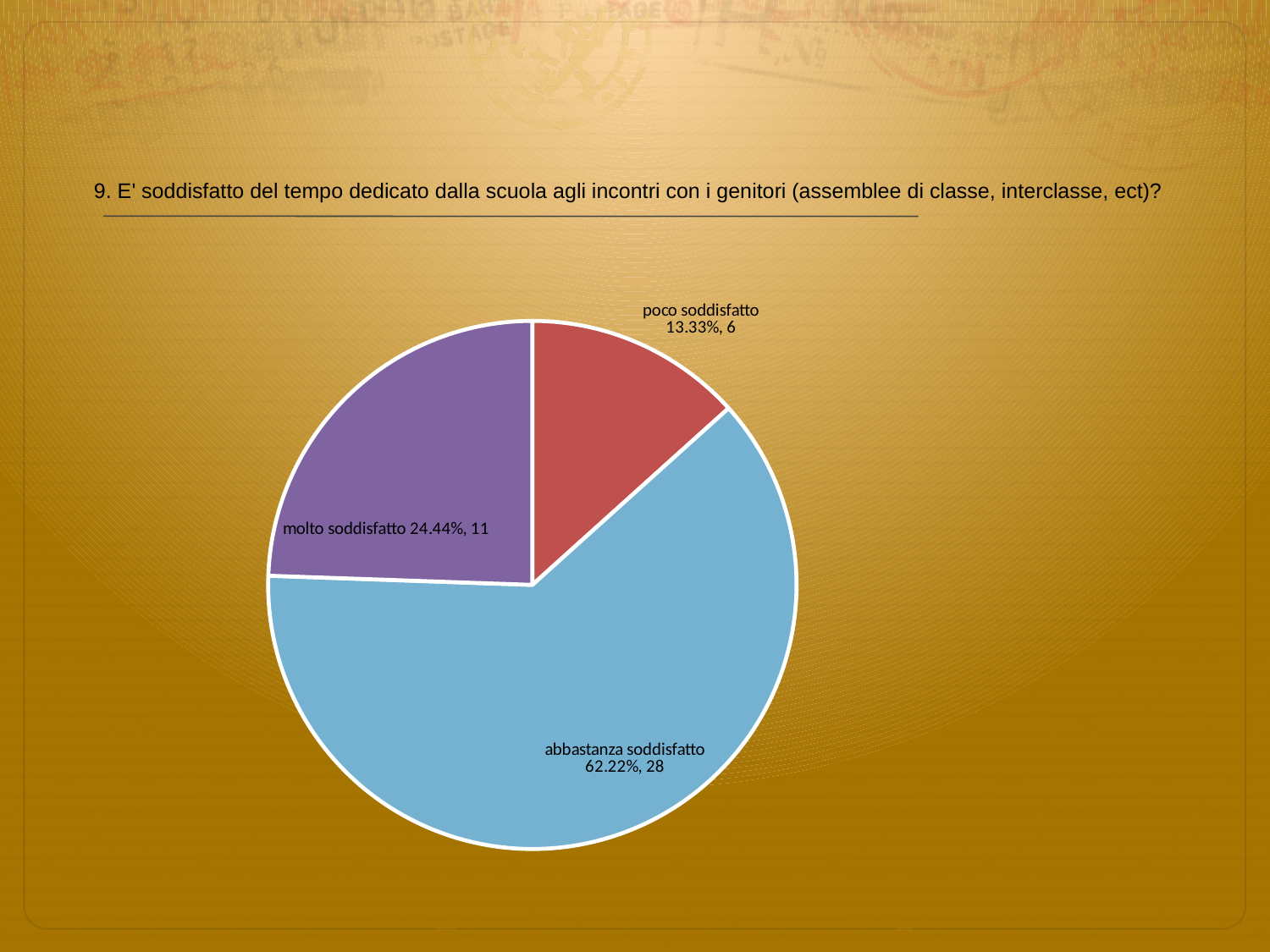
What is the difference in number of responses between 'abbastanza soddisfatto' and 'molto soddisfatto'? 17 What percentage of the pie is 'poco soddisfatto'? 13.33% What percentage of the pie is 'molto soddisfatto'? 24.44% Which category has the smallest slice of the pie? poco soddisfatto What percentage of the pie is 'abbastanza soddisfatto'? 62.22% What kind of chart is shown on the slide? pie chart Which category has the largest slice of the pie? abbastanza soddisfatto How many responses does the 'molto soddisfatto' slice represent? 11 How many slices does the pie chart have? 3 How many responses does the 'poco soddisfatto' slice represent? 6 How many responses does the 'abbastanza soddisfatto' slice represent? 28 Which slice is larger, 'molto soddisfatto' or 'poco soddisfatto'? molto soddisfatto